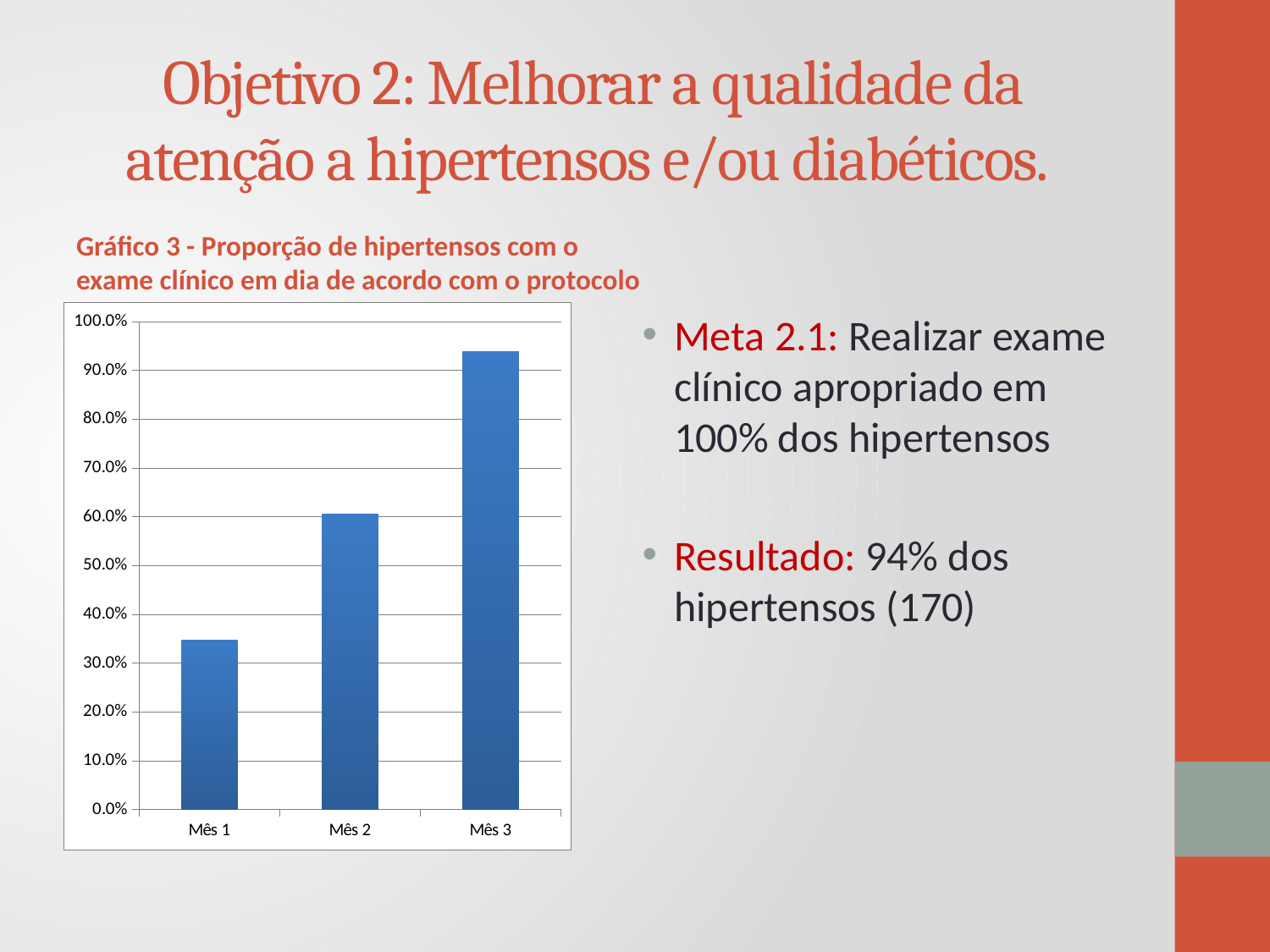
What is the highest tick value shown on the y axis of the chart? 100.0% Is the value for Mês 1 greater or less than 40.0%? less Is the value for Mês 1 greater or less than 30.0%? greater Which month has the lowest bar in the chart? Mês 1 What kind of chart is shown on the slide? bar chart What is the title of the chart? Gráfico 3 - Proporção de hipertensos com o exame clínico em dia de acordo com o protocolo Which is larger, the value for Mês 2 or the value for Mês 3? Mês 3 Is the value for Mês 2 greater or less than 50.0%? greater How many categories are plotted on the x axis of the chart? 3 Do the values rise or fall from Mês 1 to Mês 3? rise Which month has the highest bar in the chart? Mês 3